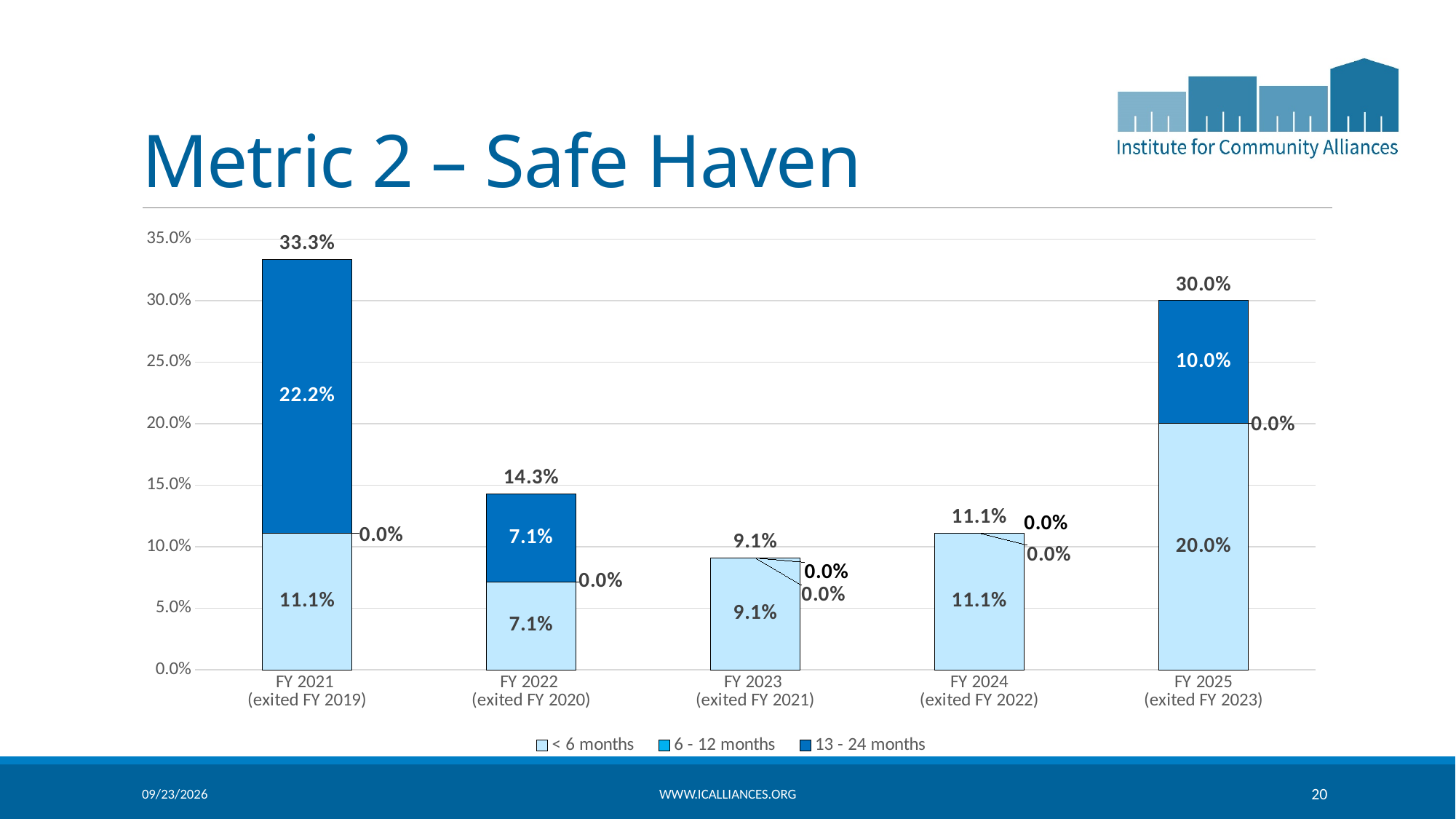
Which is larger: the '< 6 months' value for FY 2025 or for FY 2024? FY 2025 What is the value of the '< 6 months' segment for FY 2021 (exited FY 2019)? 11.1% How many fiscal year categories are shown on the x axis? 5 What is the value of the '13 - 24 months' segment for FY 2025 (exited FY 2023)? 10.0% What is the title of the slide containing the chart? Metric 2 – Safe Haven How many series does the legend list? 3 Which fiscal year has the lowest stacked bar total? FY 2023 (exited FY 2021) What is the value of the '13 - 24 months' segment for FY 2022 (exited FY 2020)? 7.1% Which fiscal year has the highest stacked bar total? FY 2021 (exited FY 2019) What is the total of the stacked bar for FY 2021 (exited FY 2019)? 33.3% What is the difference between the '13 - 24 months' values for FY 2021 and FY 2025? 12.2% What kind of chart is shown on the slide? Stacked bar chart